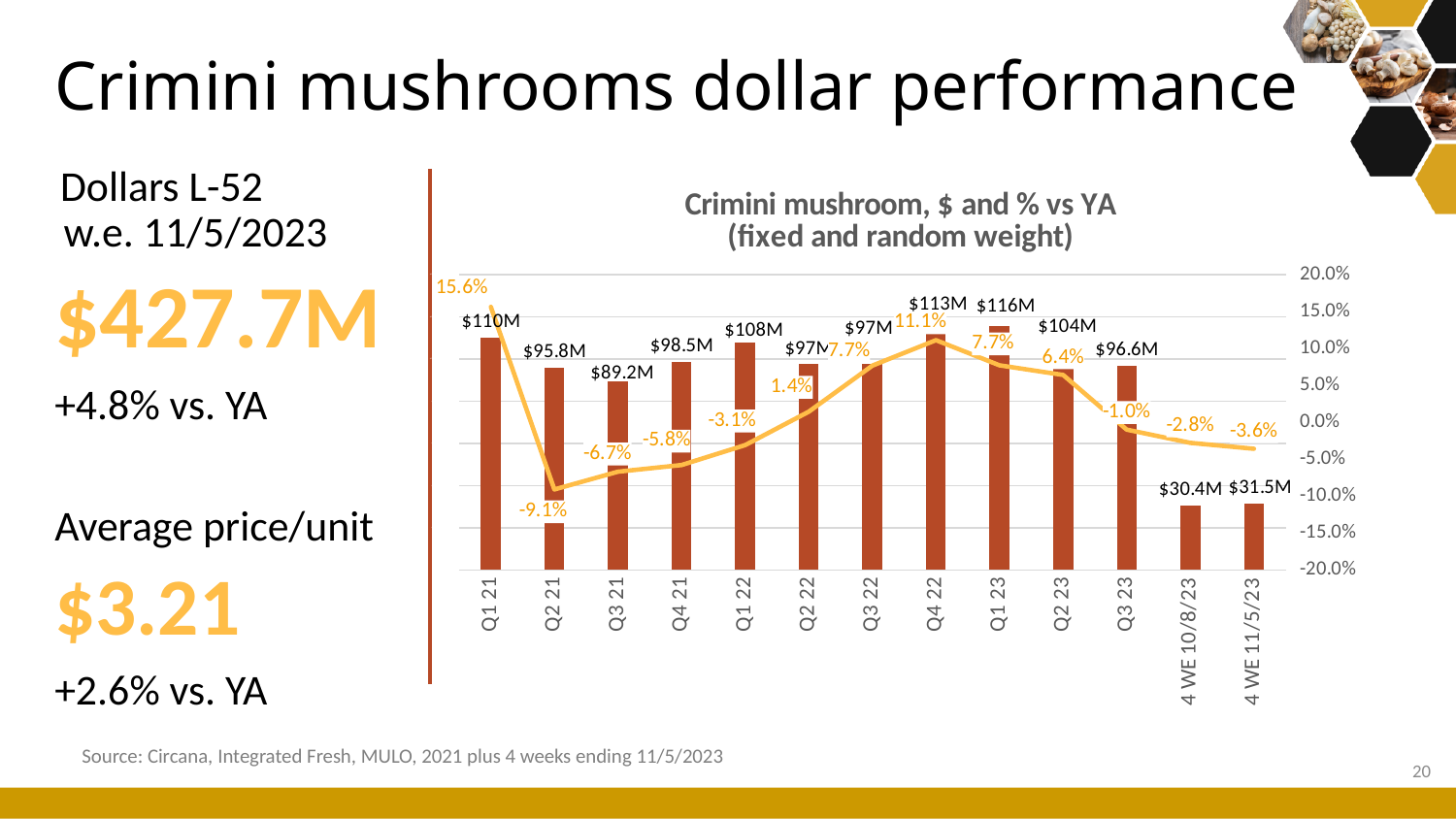
Which period has the lowest percentage change vs YA on the line? Q2 21 What is the percentage change vs YA shown for Q2 21? -9.1% Which quarter has the highest dollar value among the quarterly bars? Q1 23 What is the difference in dollar value between Q1 23 and Q2 23? $12M How many periods are shown on the x axis of the chart? 13 What is the dollar value shown for Q1 23? $116M What is the dollar value shown for the 4 WE 11/5/23 period? $31.5M Which has a higher dollar value, Q3 21 or Q4 21? Q4 21 What is the percentage change vs YA shown for Q4 22? 11.1% What is the title of the chart? Crimini mushroom, $ and % vs YA (fixed and random weight) Does the percentage change vs YA line rise or fall from Q2 21 to Q4 22? Rise What kind of chart is shown on the slide? Combination bar and line chart